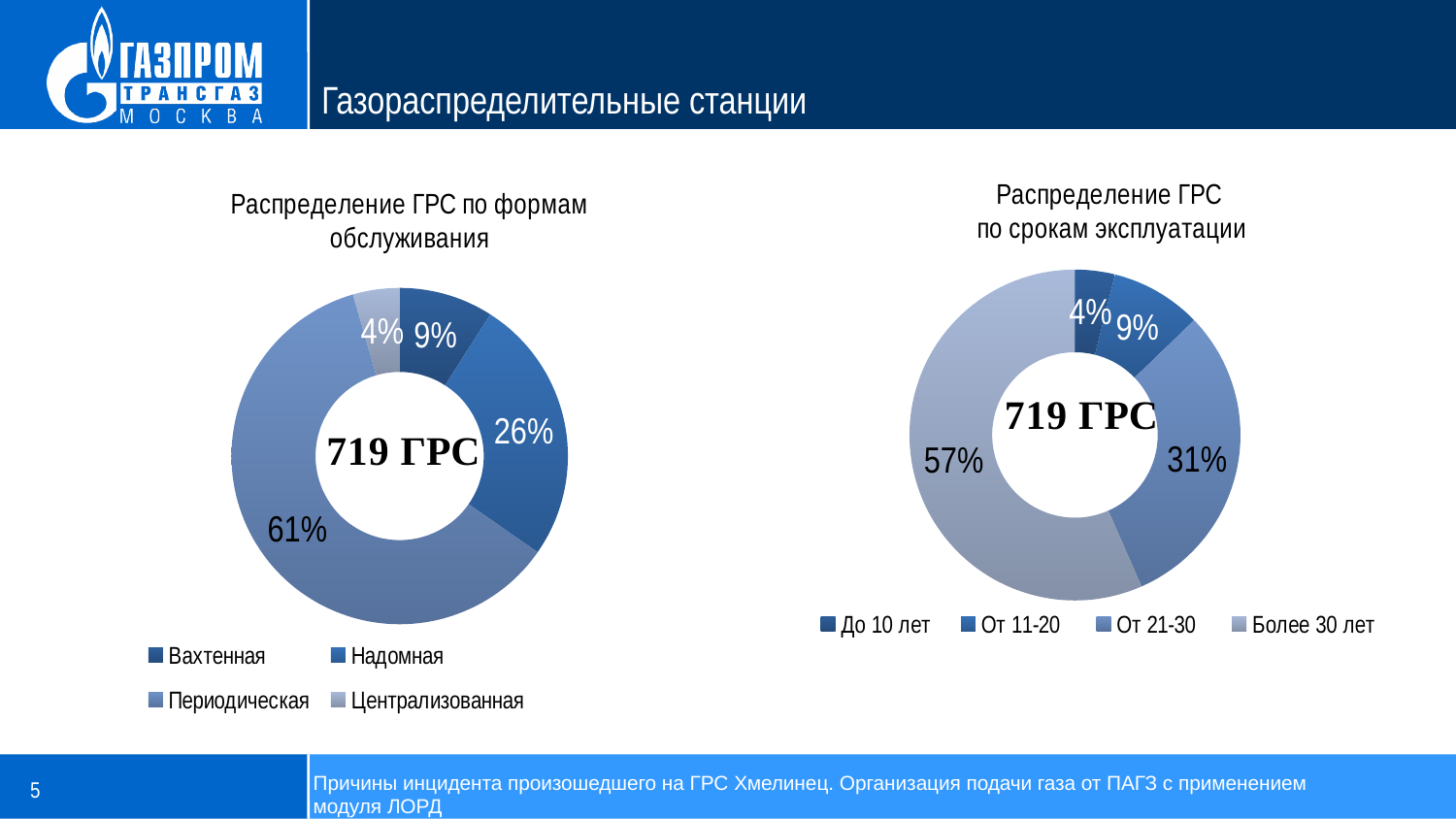
How many categories does the legend of the chart 'Распределение ГРС по срокам эксплуатации' list? 4 In the chart 'Распределение ГРС по формам обслуживания', which category has the largest share? Периодическая In the chart 'Распределение ГРС по срокам эксплуатации', what share is labelled for До 10 лет? 4% In the chart 'Распределение ГРС по формам обслуживания', what share is labelled for Периодическая? 61% In the chart 'Распределение ГРС по формам обслуживания', what share is labelled for Надомная? 26% In the chart 'Распределение ГРС по формам обслуживания', which category has the smallest share? Централизованная In the chart 'Распределение ГРС по срокам эксплуатации', what share is labelled for От 21-30? 31% What text is shown in the centre of the chart 'Распределение ГРС по срокам эксплуатации'? 719 ГРС In the chart 'Распределение ГРС по формам обслуживания', what is the difference between the shares of Надомная and Вахтенная? 17% What type of chart is 'Распределение ГРС по формам обслуживания'? Doughnut chart In the chart 'Распределение ГРС по срокам эксплуатации', which is larger: От 11-20 or Более 30 лет? Более 30 лет In the chart 'Распределение ГРС по срокам эксплуатации', which category has the largest share? Более 30 лет